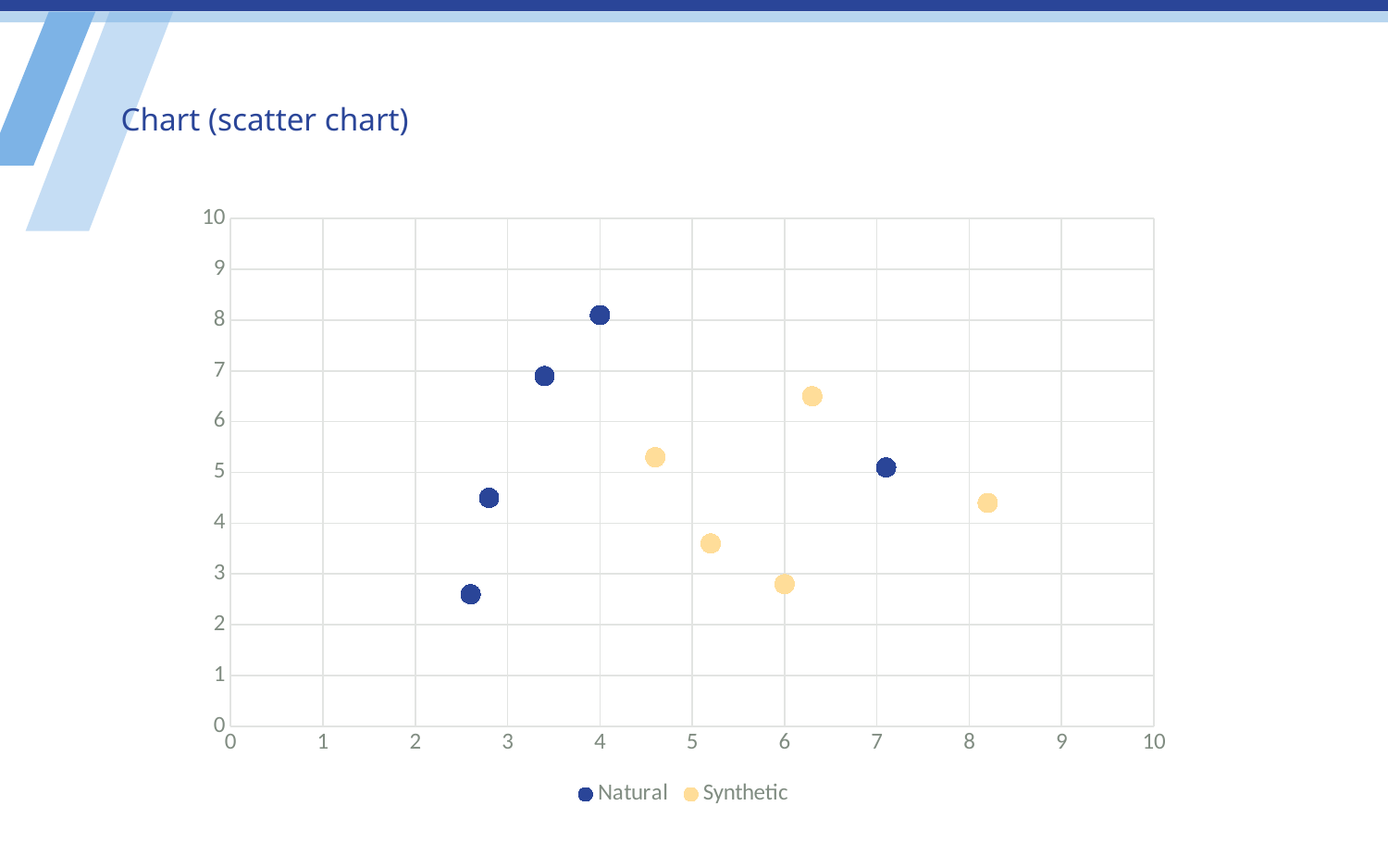
How many points are plotted in total on the chart? 10 How many series does the legend list? 2 Which series contains the point with the largest x value? Synthetic How many points are plotted for the Synthetic series? 5 Is the y value of the highest Synthetic point greater or less than 6? greater How many points are plotted for the Natural series? 5 What kind of chart is shown on the slide? scatter chart Is the y value of the highest Natural point greater or less than 7? greater What are the two series named in the legend? Natural and Synthetic What is the title of the chart? Chart (scatter chart) Which series contains the point with the highest y value? Natural Is the y value of the rightmost Synthetic point greater or less than 5? less